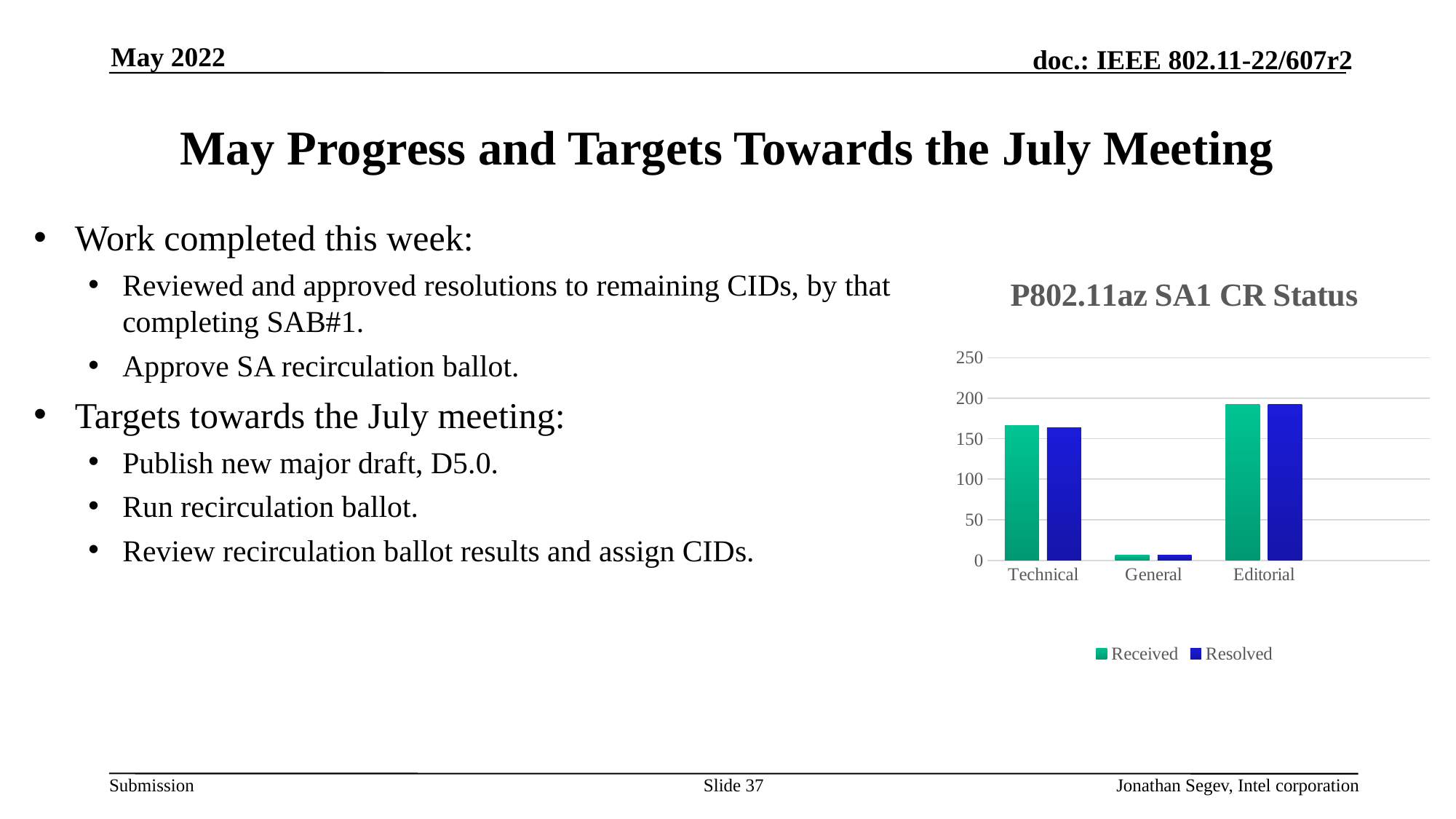
Which category has the lowest Resolved value? General What kind of chart is shown on the slide? bar chart How many categories are shown on the x axis of the chart? 3 Is the Received value for Editorial greater or less than 200? less Is the Resolved value for Editorial greater or less than 150? greater Which category has the highest Received value? Editorial Which series is shown in blue in the chart legend? Resolved Is the Resolved value for General greater or less than 50? less Which is larger, the Received value for Technical or the Received value for Editorial? Editorial What is the title of the chart? P802.11az SA1 CR Status How many series does the chart legend list? 2